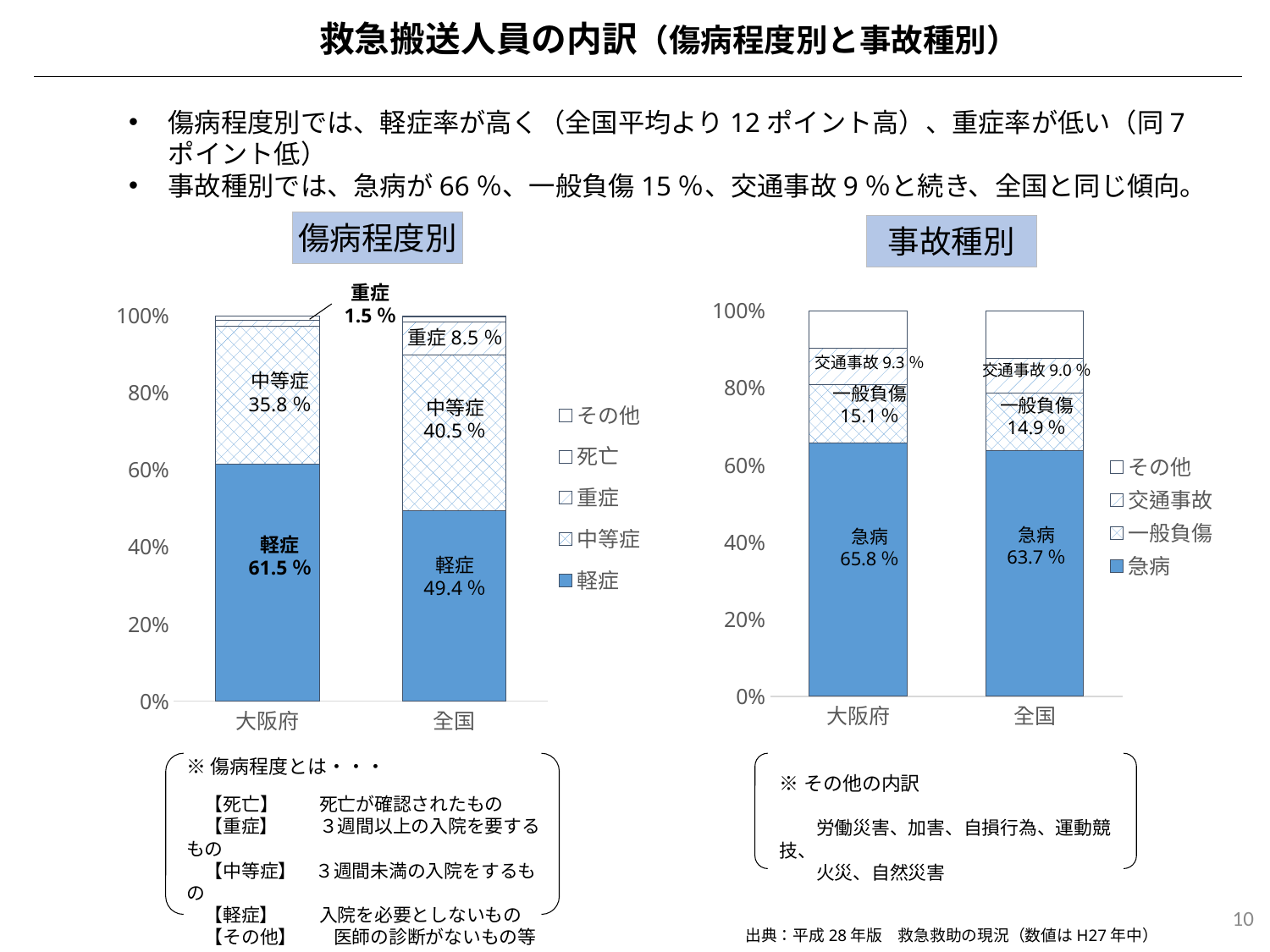
In the 事故種別 chart, what is the difference between the 一般負傷 values for 大阪府 and 全国? 0.2 % In the 傷病程度別 chart, what is the difference between the 軽症 values for 大阪府 and 全国? 12.1 % In the 傷病程度別 chart, what is the 中等症 value for 全国? 40.5 % What kind of chart is the 事故種別 chart? Stacked bar chart In the 傷病程度別 chart, which has the larger 重症 share, 大阪府 or 全国? 全国 In the 事故種別 chart, what is the 急病 value for 大阪府? 65.8 % In the 事故種別 chart, what is the 交通事故 value for 全国? 9.0 % How many series does the legend of the 傷病程度別 chart list? 5 In the 事故種別 chart, is the 急病 value for 全国 greater or less than 60%? greater In the 傷病程度別 chart, what is the 軽症 value for 大阪府? 61.5 % In the 傷病程度別 chart, what is the 重症 value for 大阪府? 1.5 % How many categories are shown on the x axis of the 事故種別 chart? 2